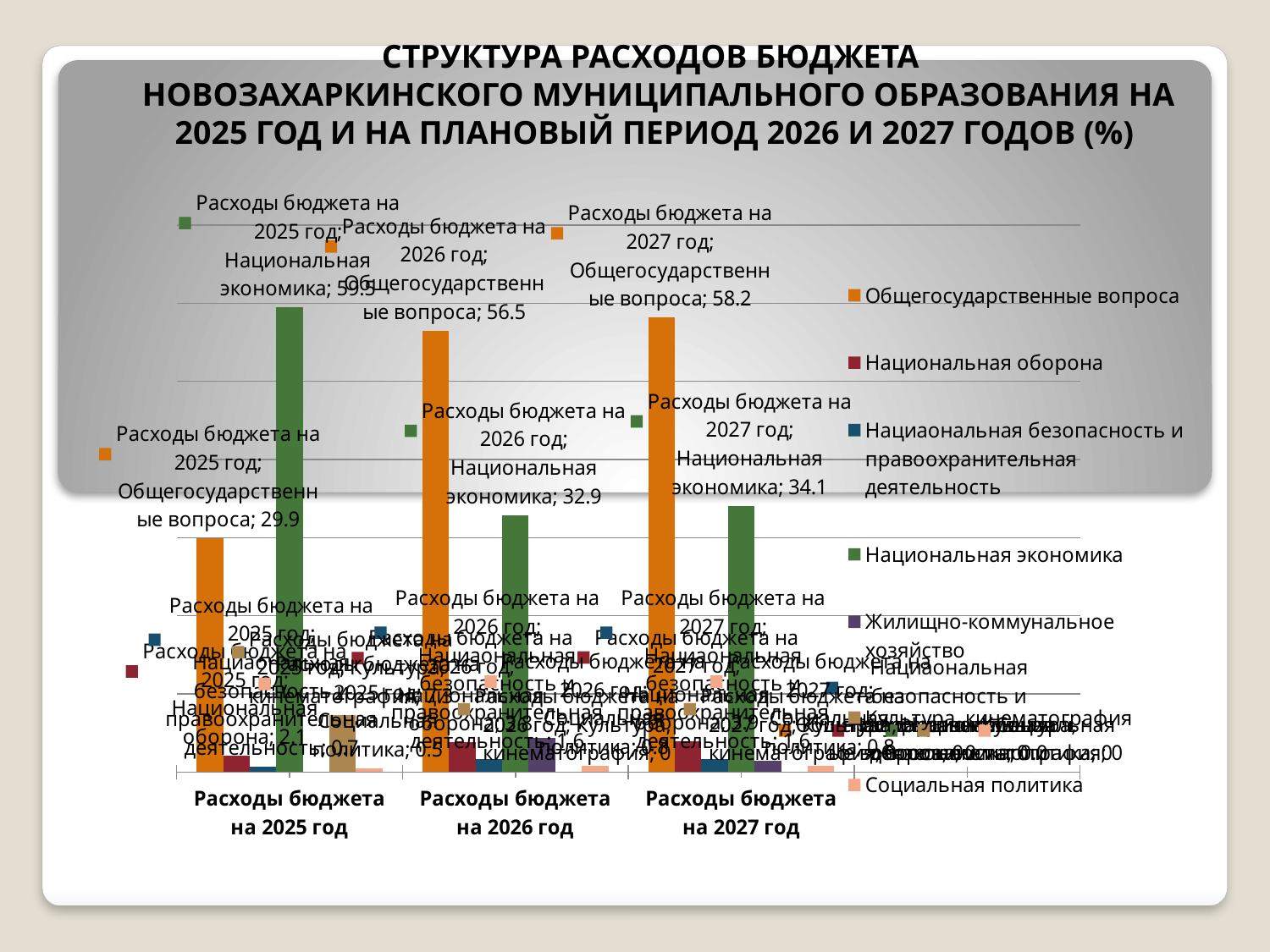
What is the value for Общегосударственные вопросы in Расходы бюджета на 2027 год? 58.2 What is the value for Национальная экономика in Расходы бюджета на 2027 год? 34.1 In Расходы бюджета на 2027 год, which is larger: Общегосударственные вопросы or Национальная экономика? Общегосударственные вопросы What is the difference between Национальная экономика and Общегосударственные вопросы in Расходы бюджета на 2025 год? 29.6 What kind of chart is shown on the slide? Bar chart In which budget year is the value for Национальная экономика the highest? Расходы бюджета на 2025 год How many budget-year categories are shown on the x axis? 3 In Расходы бюджета на 2025 год, which is larger: Национальная экономика or Общегосударственные вопросы? Национальная экономика What is the value for Национальная экономика in Расходы бюджета на 2025 год? 59.5 What is the value for Национальная экономика in Расходы бюджета на 2026 год? 32.9 What is the value for Общегосударственные вопросы in Расходы бюджета на 2025 год? 29.9 What is the value for Общегосударственные вопросы in Расходы бюджета на 2026 год? 56.5